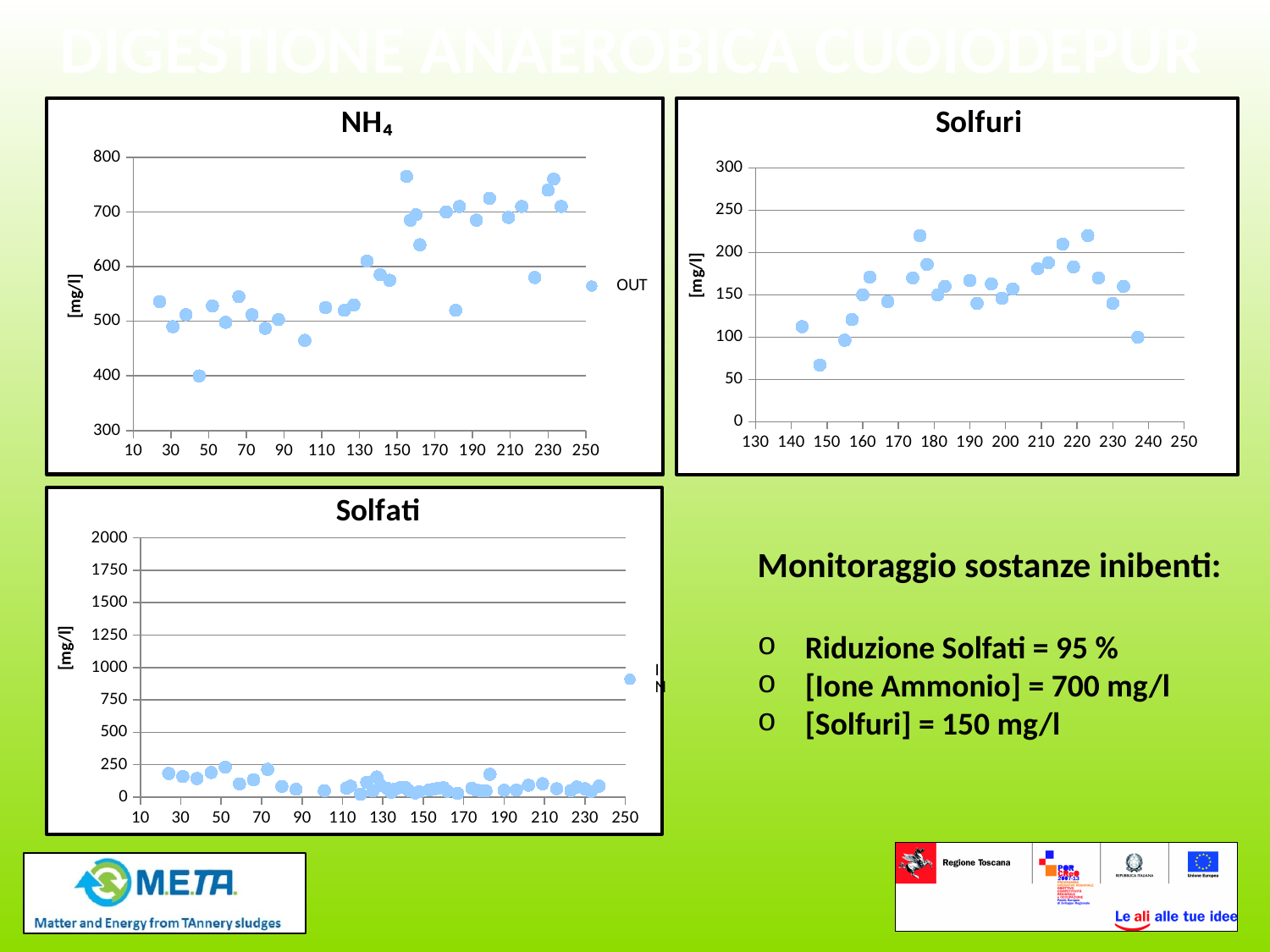
In the Solfuri chart, is the value of the point near x = 175 greater or less than 200? greater In the Solfuri chart, is the value of the lowest point (near x = 148) greater or less than 100? less In the NH₄ chart, do the values generally rise or fall as the x axis increases from 10 to 250? rise In the NH₄ chart, is the value of the point at x = 45 greater or less than 500? less What kind of chart is the Solfuri chart? scatter chart What is the y-axis label of the Solfati chart? [mg/l] In the NH₄ chart, what is the legend entry for the plotted series? OUT What kind of chart is the NH₄ chart? scatter chart How many charts are shown on the slide? 3